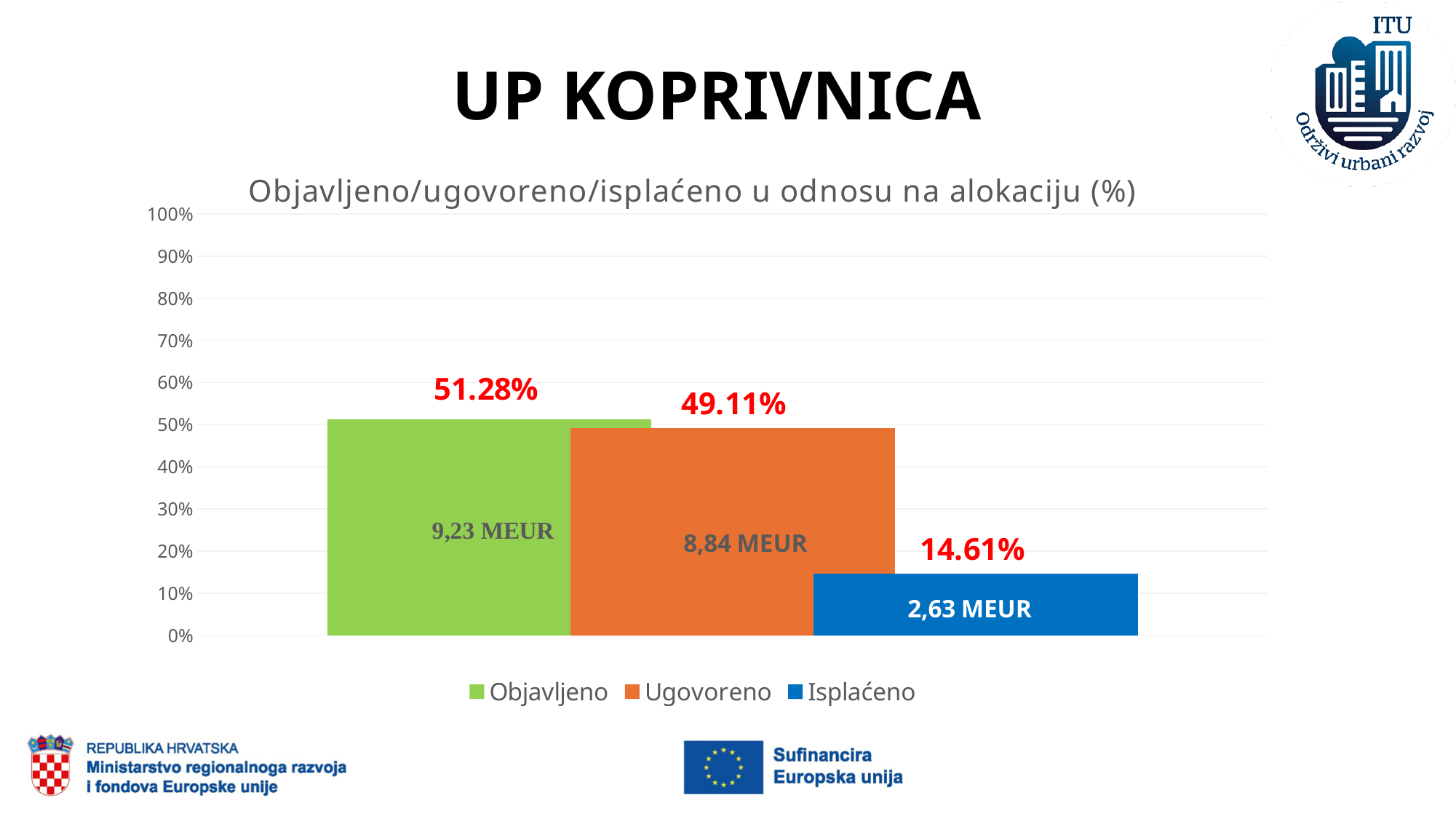
What amount in MEUR is shown on the Isplaćeno bar? 2,63 MEUR Which series has the lowest percentage value? Isplaćeno What is the value for Ugovoreno? 49.11% How many series does the legend list? 3 What is the value for Objavljeno? 51.28% What is the value for Isplaćeno? 14.61% What is the title of the chart? Objavljeno/ugovoreno/isplaćeno u odnosu na alokaciju (%) Which is larger, the value for Ugovoreno or the value for Isplaćeno? Ugovoreno What kind of chart is shown on the slide? Bar chart What is the difference in percentage points between Objavljeno and Ugovoreno? 2.17 Which series has the highest percentage value? Objavljeno What amount in MEUR is shown on the Objavljeno bar? 9,23 MEUR